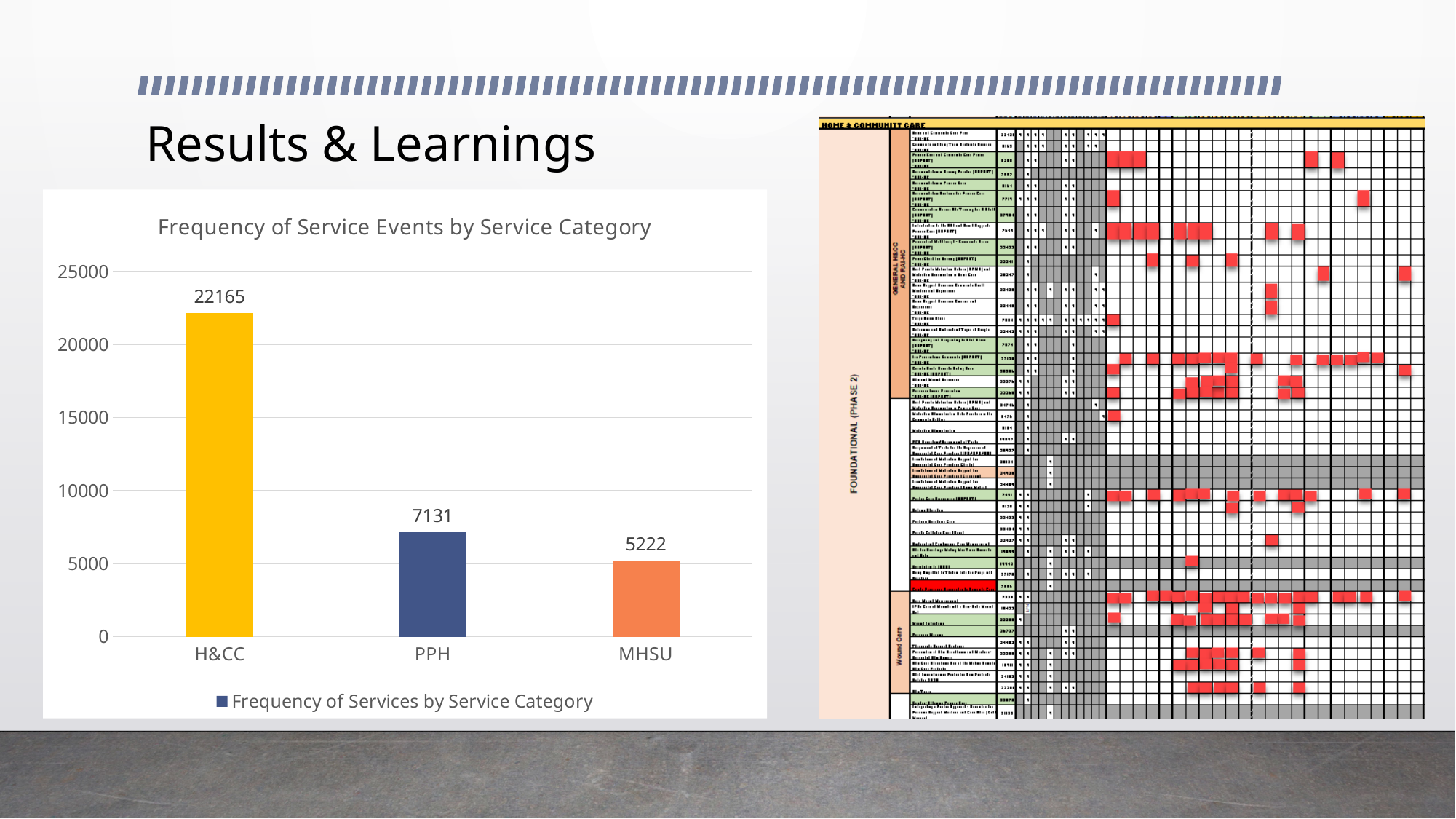
What is the value for MHSU in the Frequency of Service Events by Service Category chart? 5222 What is the value for PPH in the Frequency of Service Events by Service Category chart? 7131 Which is larger, the value for PPH or the value for MHSU? PPH Is the value for H&CC greater or less than 20000? greater How many service categories are shown in the bar chart? 3 What is the difference between the values for PPH and MHSU? 1909 What is the difference between the values for H&CC and PPH? 15034 What is the legend entry shown below the bar chart? Frequency of Services by Service Category Which service category has the lowest frequency of service events? MHSU What is the value for H&CC in the Frequency of Service Events by Service Category chart? 22165 Which service category has the highest frequency of service events? H&CC What kind of chart is used to show Frequency of Service Events by Service Category? bar chart